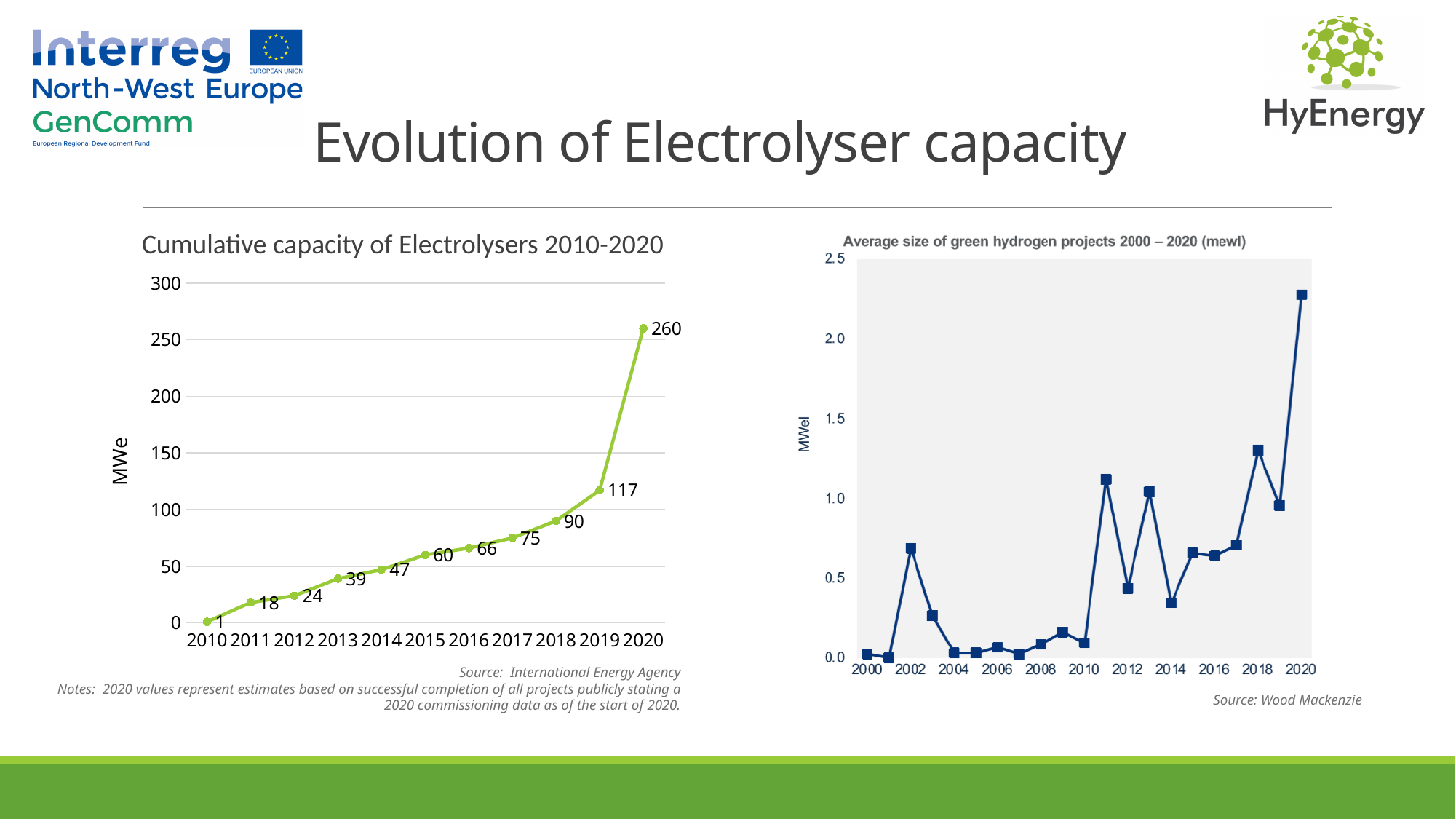
In the 'Cumulative capacity of Electrolysers 2010-2020' chart, what is the value for 2019? 117 In the 'Cumulative capacity of Electrolysers 2010-2020' chart, do the values rise or fall from 2010 to 2020? rise In the 'Cumulative capacity of Electrolysers 2010-2020' chart, which year has the lowest value? 2010 In the 'Average size of green hydrogen projects 2000 – 2020 (mewl)' chart, is the value for 2002 greater or less than 1.0? less In the 'Cumulative capacity of Electrolysers 2010-2020' chart, what is the difference between the values for 2020 and 2019? 143 In the 'Cumulative capacity of Electrolysers 2010-2020' chart, which year has the highest value? 2020 In the 'Average size of green hydrogen projects 2000 – 2020 (mewl)' chart, which year has the highest value? 2020 What kind of chart is the 'Average size of green hydrogen projects 2000 – 2020 (mewl)' chart? line chart In the 'Cumulative capacity of Electrolysers 2010-2020' chart, what is the difference between the values for 2018 and 2017? 15 In the 'Cumulative capacity of Electrolysers 2010-2020' chart, how many years are plotted? 11 In the 'Average size of green hydrogen projects 2000 – 2020 (mewl)' chart, is the value for 2020 greater or less than 2.0? greater In the 'Cumulative capacity of Electrolysers 2010-2020' chart, what is the value for 2015? 60